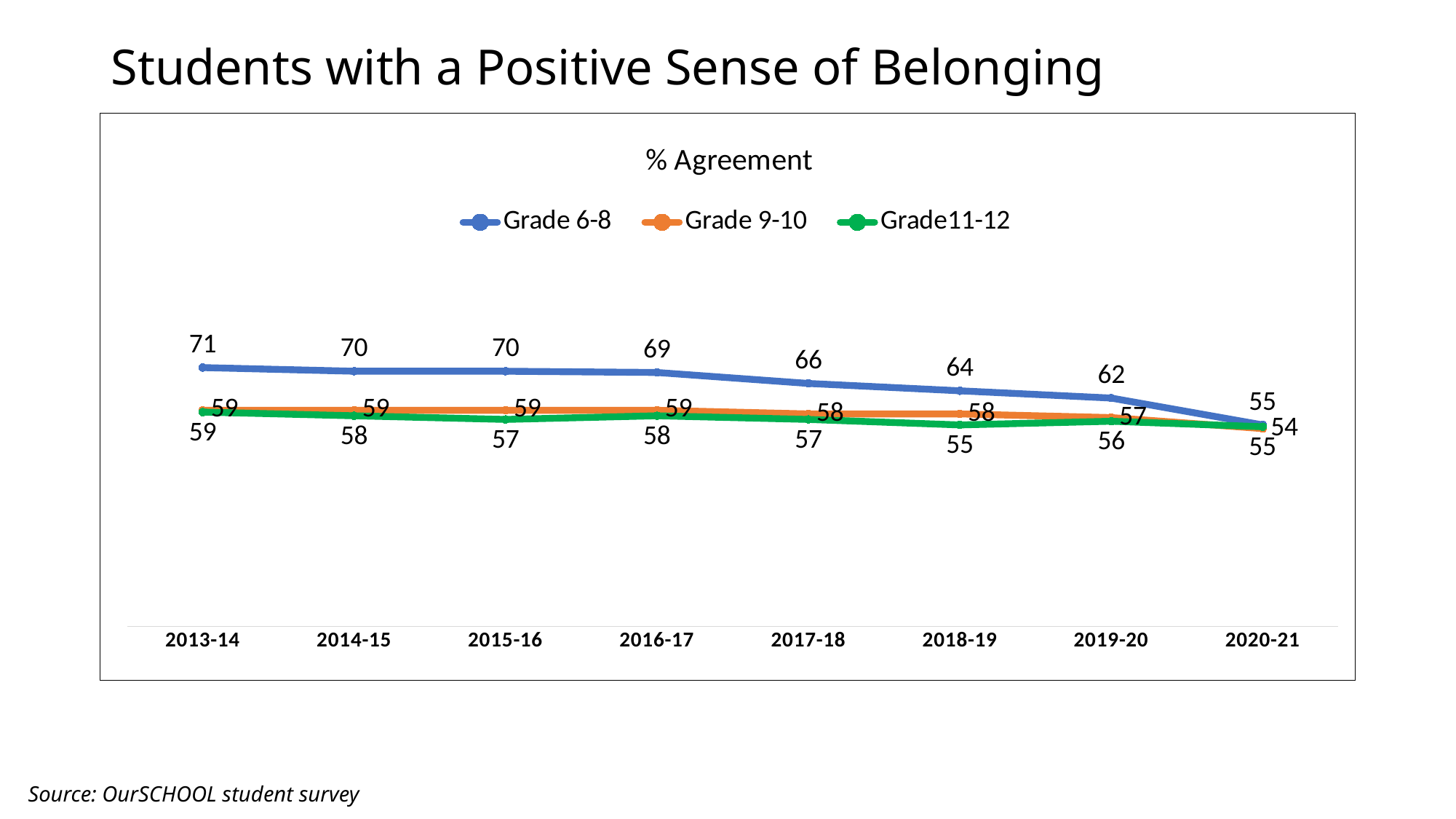
What is the % Agreement for Grade 6-8 in 2013-14? 71 Does the Grade 6-8 line rise or fall from 2013-14 to 2020-21? fall How many series does the legend list? 3 What is the % Agreement for Grade 11-12 in 2018-19? 55 What is the % Agreement for Grade 9-10 in 2019-20? 57 What type of chart is shown on the slide? line chart How many school years are shown on the x axis? 8 Which series has the higher value in 2017-18, Grade 6-8 or Grade 11-12? Grade 6-8 What is the % Agreement for Grade 6-8 in 2020-21? 55 In which school year is the Grade 6-8 value highest? 2013-14 In which school year is the Grade 6-8 value lowest? 2020-21 What is the difference between the Grade 6-8 value in 2013-14 and in 2020-21? 16